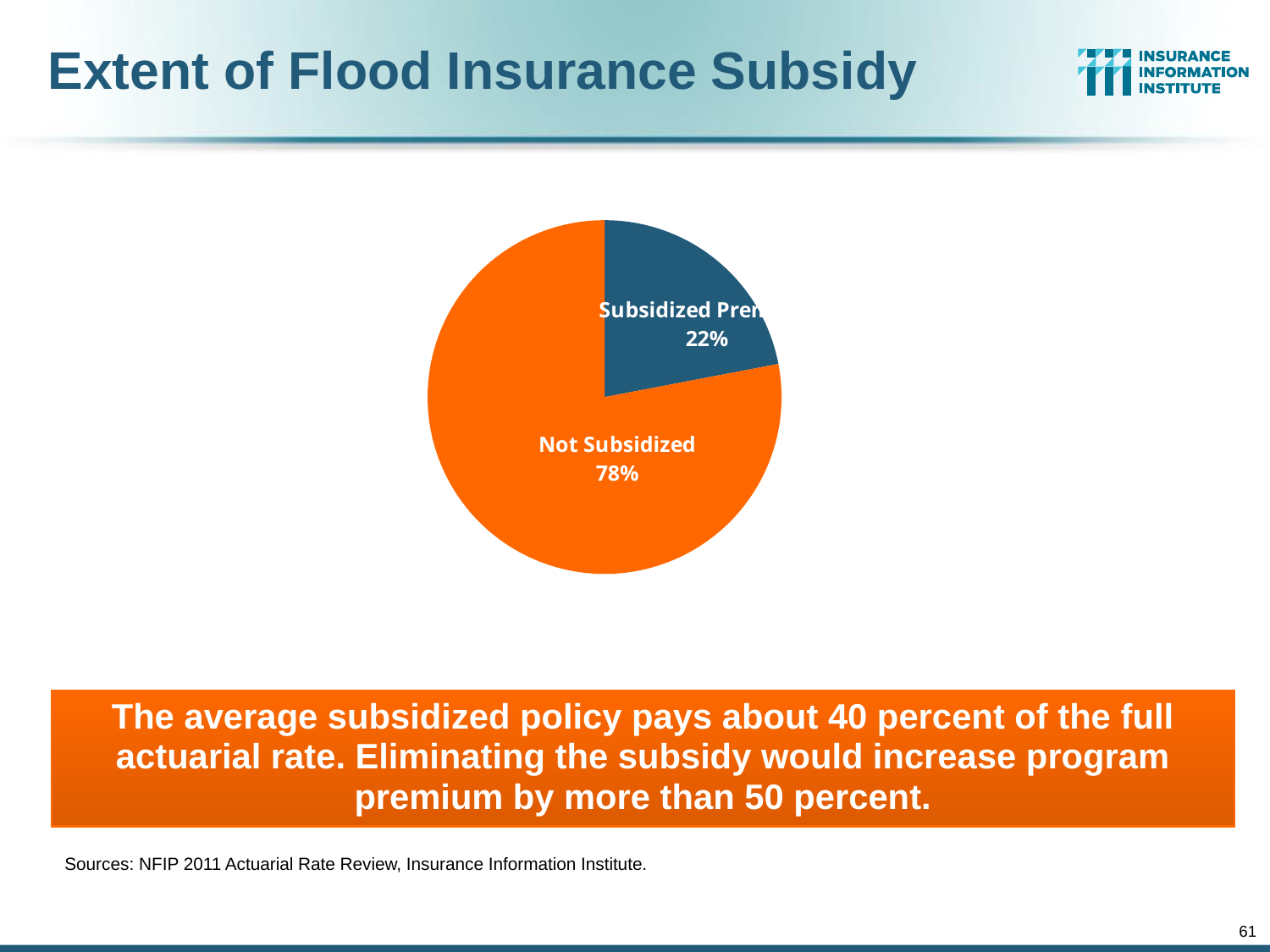
Which slice of the pie is the largest? Not Subsidized What percentage is shown for the Subsidized slice of the pie? 22% By how many percentage points does the Not Subsidized slice exceed the Subsidized slice? 56 percentage points Is the Subsidized slice of the pie greater or less than 50%? less How many slices does the pie chart have? 2 What share of the pie is labelled Not Subsidized? 78% Which slice of the pie is the smallest? Subsidized What share of the pie does the Not Subsidized slice represent? 78% What colour is the Not Subsidized slice of the pie? Orange What kind of chart is shown on the slide? Pie chart What colour is the Subsidized slice of the pie? Dark blue Which is larger, the Not Subsidized slice or the Subsidized slice? Not Subsidized